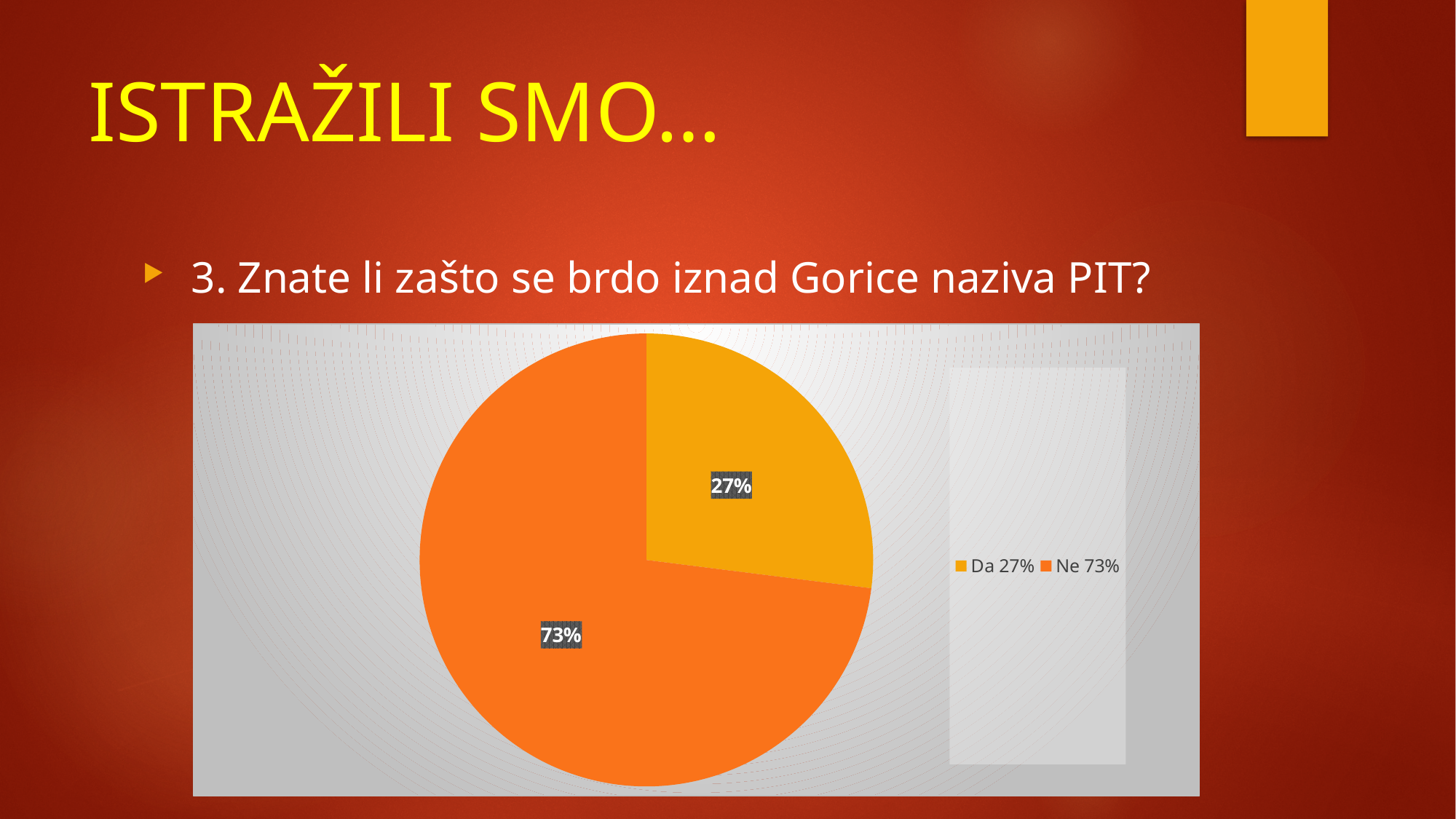
What kind of chart is shown on the slide? pie chart What survey question does the pie chart relate to, as written above it? 3. Znate li zašto se brdo iznad Gorice naziva PIT? What is the legend entry for the darker orange slice? Ne 73% How many entries does the legend list? 2 What share of the pie does the "Ne" slice represent? 73% Which slice is the largest in the pie chart? Ne Which is larger, the "Da" slice or the "Ne" slice? Ne Which slice is the smallest in the pie chart? Da What is the difference in percentage points between the "Ne" and "Da" slices? 46 What share of the pie does the "Da" slice represent? 27% How many slices does the pie chart have? 2